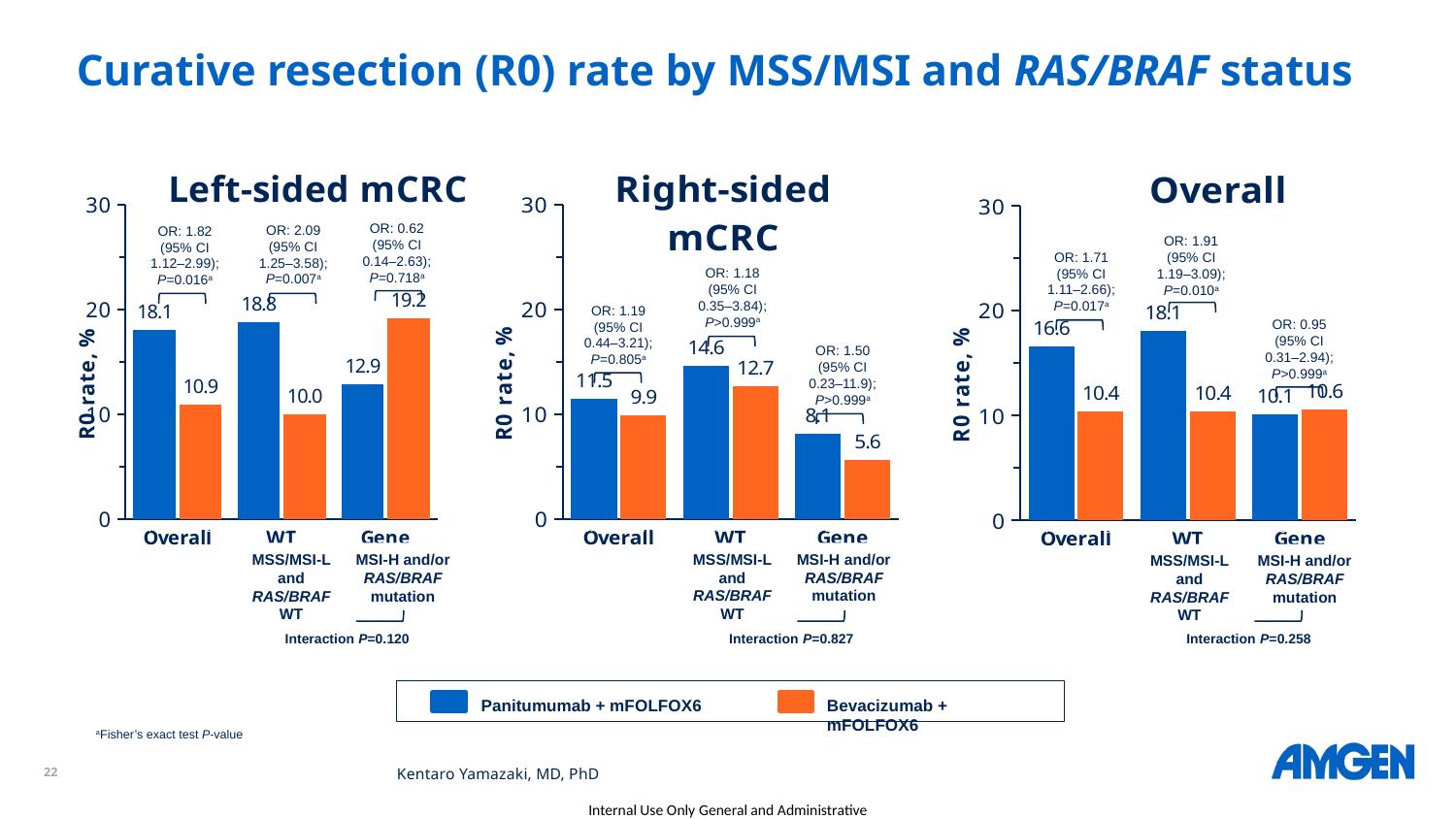
In the Right-sided mCRC chart, what is the R0 rate for Bevacizumab + mFOLFOX6 in the Gene category? 5.6 In the Right-sided mCRC chart, which category has the lowest R0 rate for Bevacizumab + mFOLFOX6? Gene In the Right-sided mCRC chart, is the R0 rate for Panitumumab + mFOLFOX6 in the WT category greater or less than 10? greater In the Left-sided mCRC chart, what is the R0 rate for Panitumumab + mFOLFOX6 in the Overall category? 18.1 In the Overall chart, what is the R0 rate for Panitumumab + mFOLFOX6 in the WT category? 18.1 In the Left-sided mCRC chart, what is the R0 rate for Bevacizumab + mFOLFOX6 in the Gene category? 19.2 How many categories are shown on the x axis of the Overall chart? 3 What type of chart is the Right-sided mCRC chart? Bar chart In the Left-sided mCRC chart, what is the difference between the Panitumumab + mFOLFOX6 and Bevacizumab + mFOLFOX6 R0 rates in the WT category? 8.8 In the Overall chart, which series has the larger R0 rate in the Gene category? Bevacizumab + mFOLFOX6 How many series does the legend list for the charts? 2 In the Left-sided mCRC chart, which category has the highest R0 rate for Panitumumab + mFOLFOX6? WT